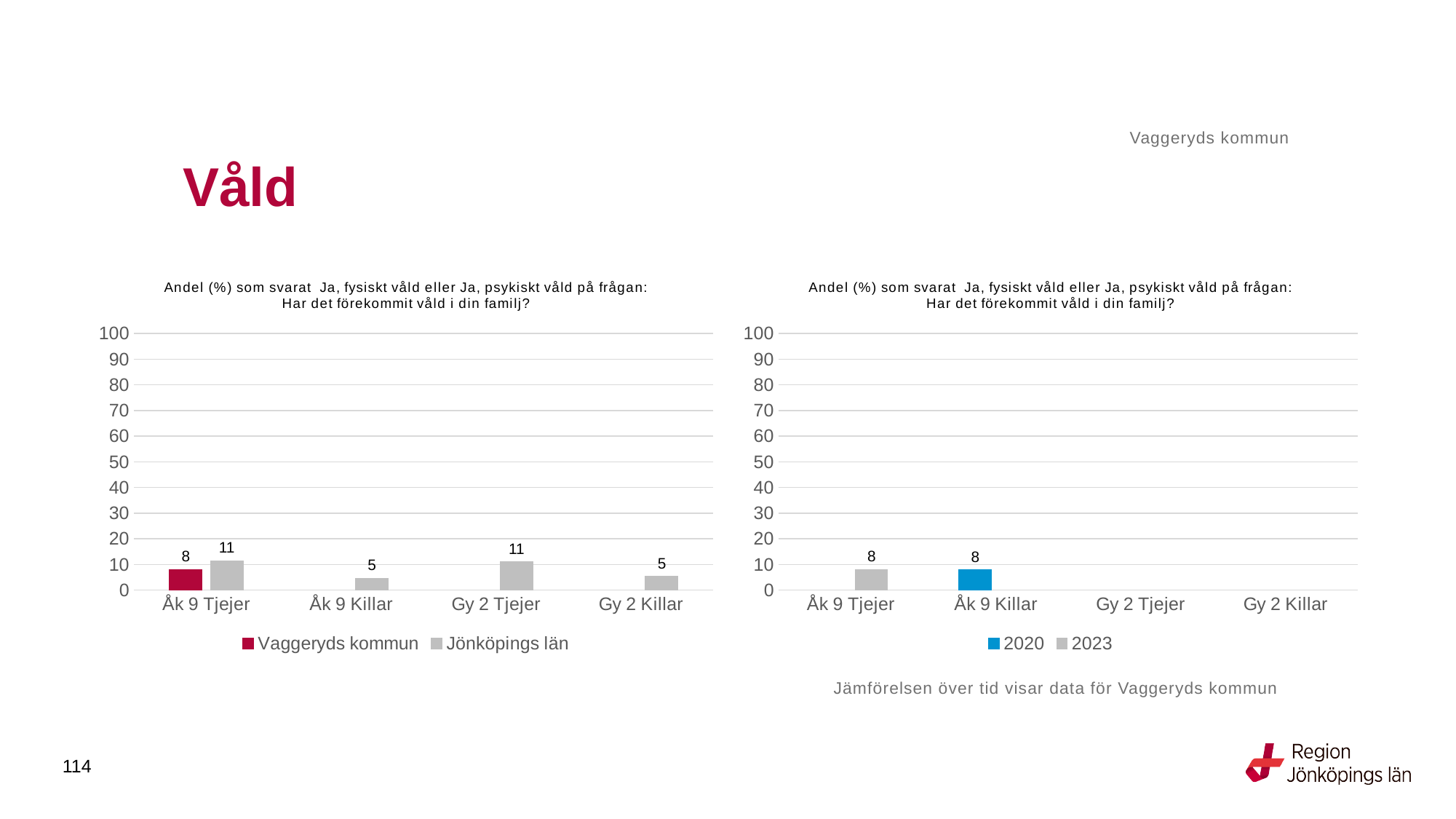
In the left chart, how many series does the legend list? 2 In the left chart, is the value for Jönköpings län for Gy 2 Tjejer greater or less than 20? less In the left chart, what is the difference between the Jönköpings län value and the Vaggeryds kommun value for Åk 9 Tjejer? 3 In the left chart, what is the value for Vaggeryds kommun for Åk 9 Tjejer? 8 In the left chart, how many categories are shown on the x axis? 4 In the left chart, what is the value for Jönköpings län for Åk 9 Tjejer? 11 In the right chart, what is the value for 2020 for Åk 9 Killar? 8 In the left chart, what is the value for Jönköpings län for Gy 2 Killar? 5 In the right chart, which series is shown in blue? 2020 In the right chart, what is the value for 2023 for Åk 9 Tjejer? 8 What kind of chart is the left chart? Bar chart In the left chart, which category has the lowest value for Jönköpings län, Åk 9 Killar or Gy 2 Tjejer? Åk 9 Killar